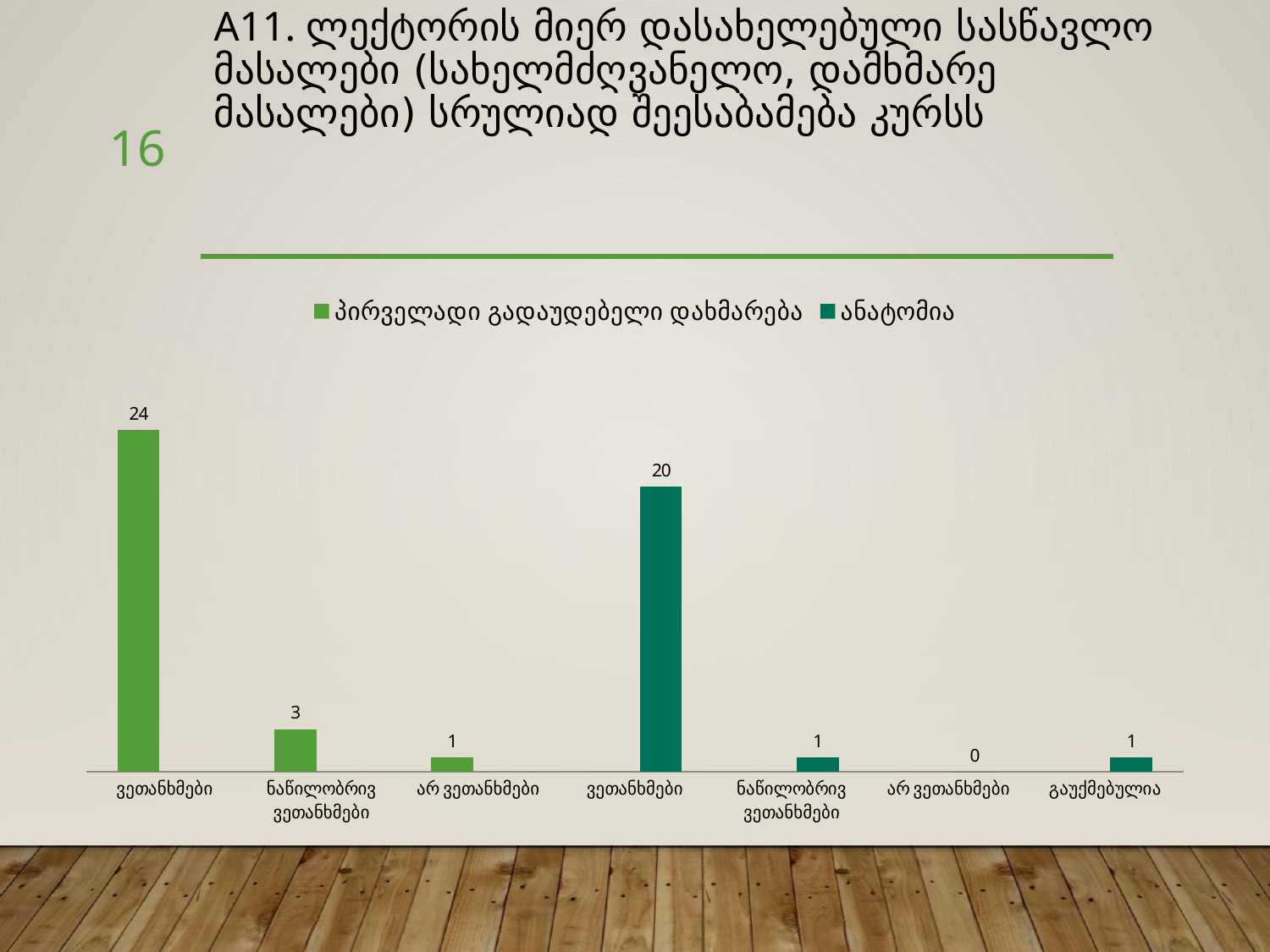
How many series does the legend list? 2 What is the value of the ნაწილობრივ ვეთანხმები bar for the პირველადი გადაუდებელი დახმარება series? 3 Which bar has the highest value on the chart? ვეთანხმები (პირველადი გადაუდებელი დახმარება) Which is larger: the ნაწილობრივ ვეთანხმები value for პირველადი გადაუდებელი დახმარება or for ანატომია? პირველადი გადაუდებელი დახმარება What is the value of the ვეთანხმები bar for the ანატომია series? 20 What is the difference between the ვეთანხმები values of the two series (24 and 20)? 4 What is the value of the არ ვეთანხმები bar for the ანატომია series? 0 Which series is shown in dark green in the legend? ანატომია How many bars (category positions) are plotted along the x axis? 7 What kind of chart is shown on the slide? bar chart What is the value of the ვეთანხმები bar for the პირველადი გადაუდებელი დახმარება series? 24 What is the value of the გაუქმებულია bar? 1